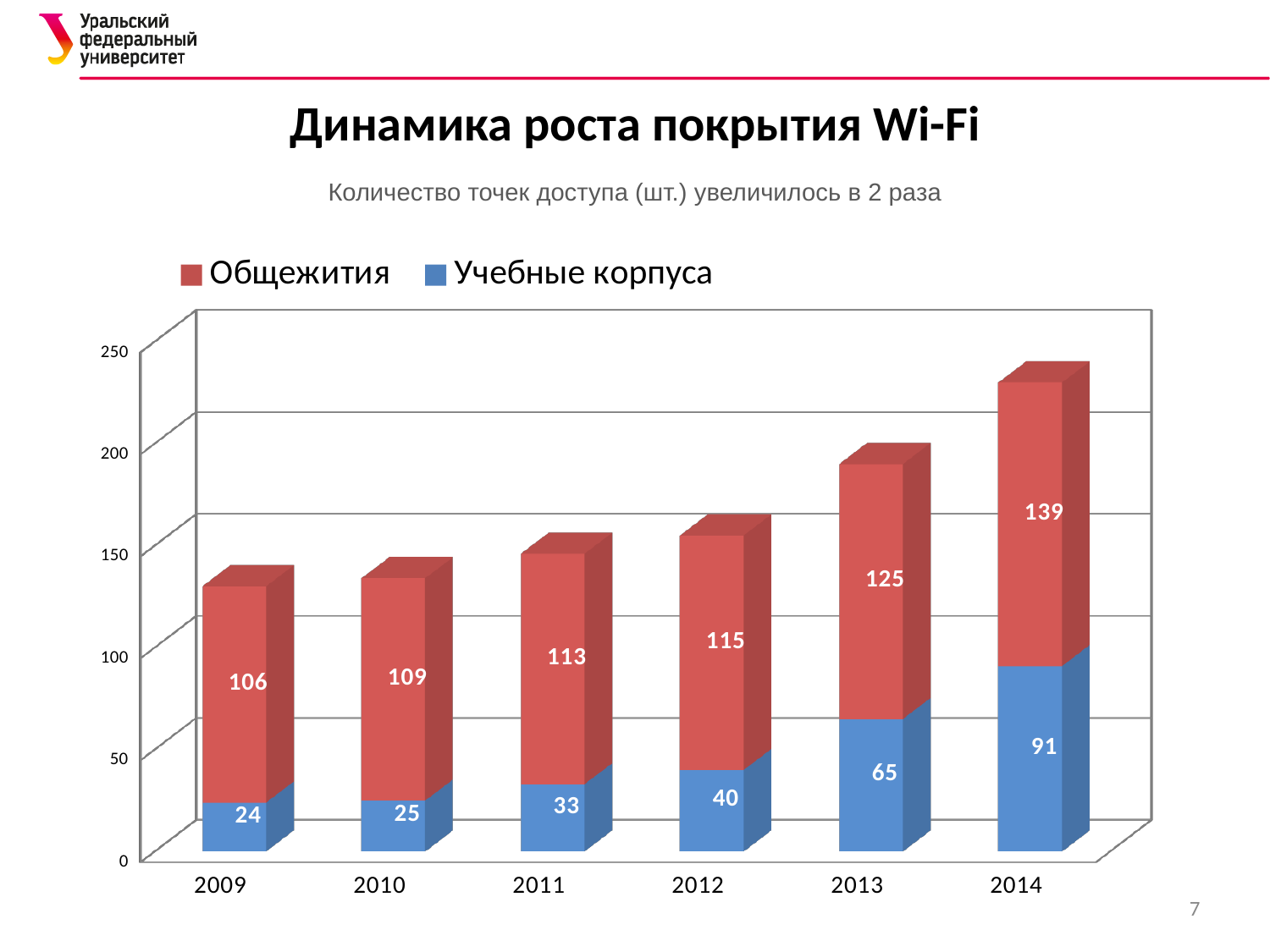
In which year is the value for Общежития the lowest? 2009 What is the difference between the Общежития values for 2014 and 2009? 33 Which is larger: Учебные корпуса in 2011 or Учебные корпуса in 2012? 2012 How many series does the legend list? 2 What is the value for Учебные корпуса in 2013? 65 What type of chart is shown on the slide? Stacked bar chart What is the title of the chart? Динамика роста покрытия Wi-Fi In which year is the value for Учебные корпуса the highest? 2014 How many years are shown on the x axis? 6 What is the value for Общежития in 2012? 115 What is the total of the stacked bar for 2014? 230 Do the values for Учебные корпуса rise or fall from 2009 to 2014? Rise